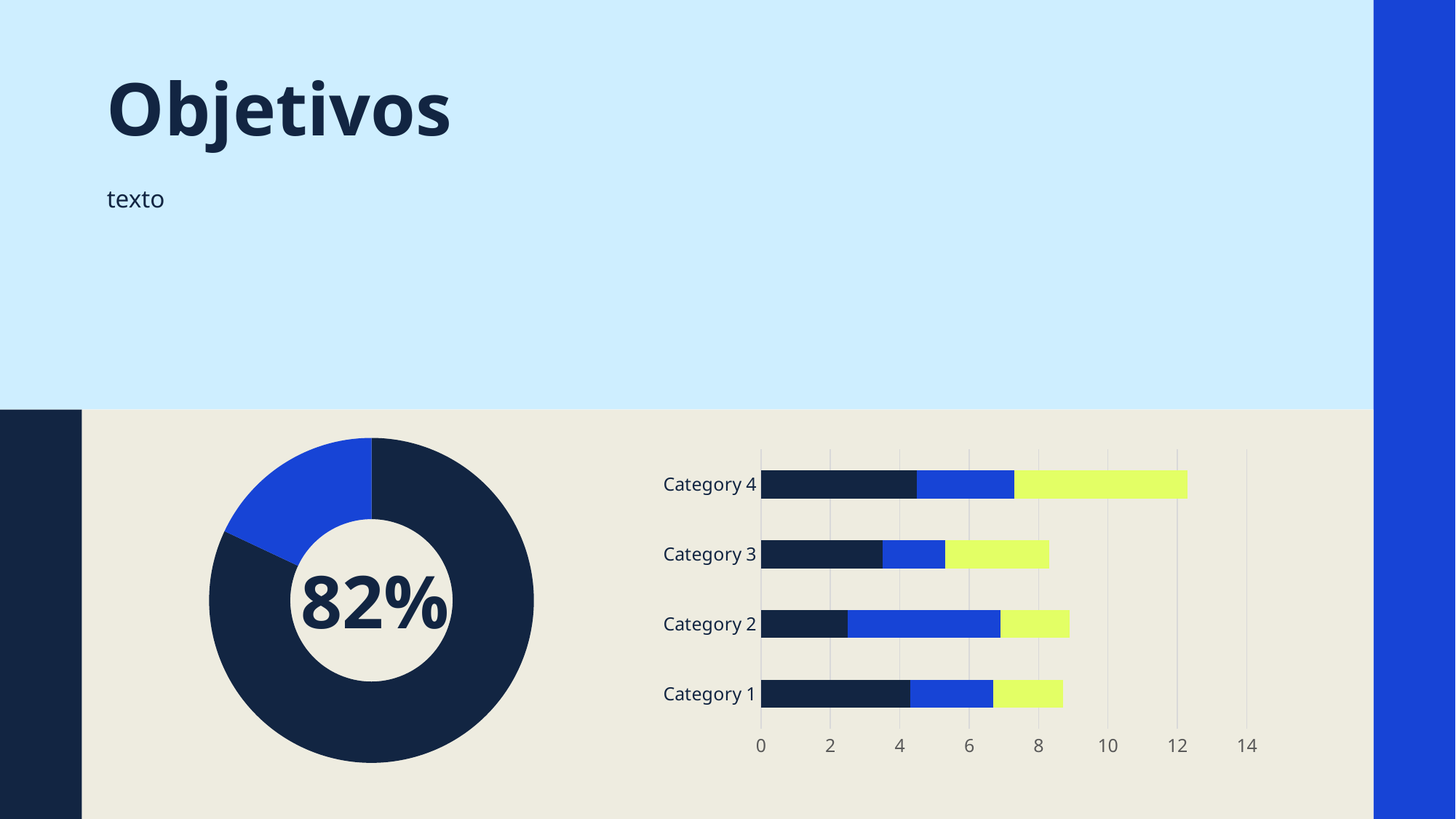
In the bar chart on the right, is the total bar for Category 2 greater or less than 10? less In the bar chart on the right, is the total bar for Category 3 greater or less than 10? less In the bar chart on the right, is the dark navy segment for Category 2 greater or less than 4? less What percentage is printed in the centre of the donut chart on the left? 82% In the bar chart on the right, what is the highest value shown on the horizontal axis? 14 What kind of chart is the chart on the right of the slide? Stacked bar chart In the bar chart on the right, how many categories are shown? 4 In the bar chart on the right, which has the longer total bar, Category 4 or Category 3? Category 4 What kind of chart is the chart on the left of the slide? Donut chart In the bar chart on the right, how many coloured segments make up each bar? 3 In the bar chart on the right, which category has the longest total bar? Category 4